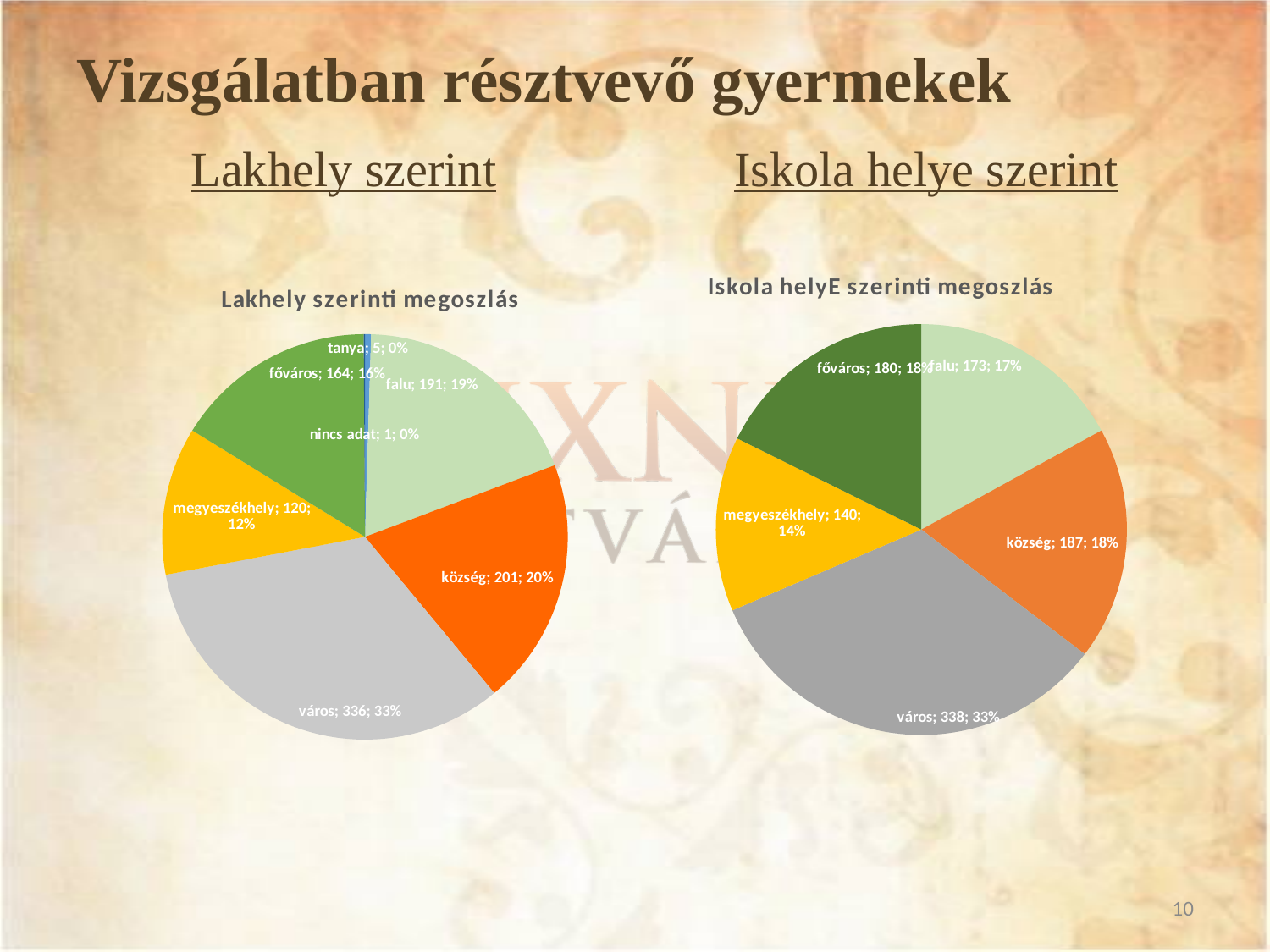
In the 'Lakhely szerinti megoszlás' chart, what is the difference between the values for község and falu? 10 In the 'Lakhely szerinti megoszlás' chart, what share of the pie does község have? 20% In the 'Iskola helyE szerinti megoszlás' chart, which is larger, község or főváros? község How many slices does the 'Lakhely szerinti megoszlás' chart have? 7 In the 'Iskola helyE szerinti megoszlás' chart, what is the difference between the values for város and község? 151 In the 'Lakhely szerinti megoszlás' chart, which category has the smallest slice? nincs adat How many slices does the 'Iskola helyE szerinti megoszlás' chart have? 5 In the 'Iskola helyE szerinti megoszlás' chart, what share of the pie does falu have? 17% In the 'Iskola helyE szerinti megoszlás' chart, what is the value for megyeszékhely? 140 In the 'Lakhely szerinti megoszlás' chart, what is the value for város? 336 What kind of chart is the 'Lakhely szerinti megoszlás' chart? pie chart In the 'Lakhely szerinti megoszlás' chart, which category has the largest slice? város